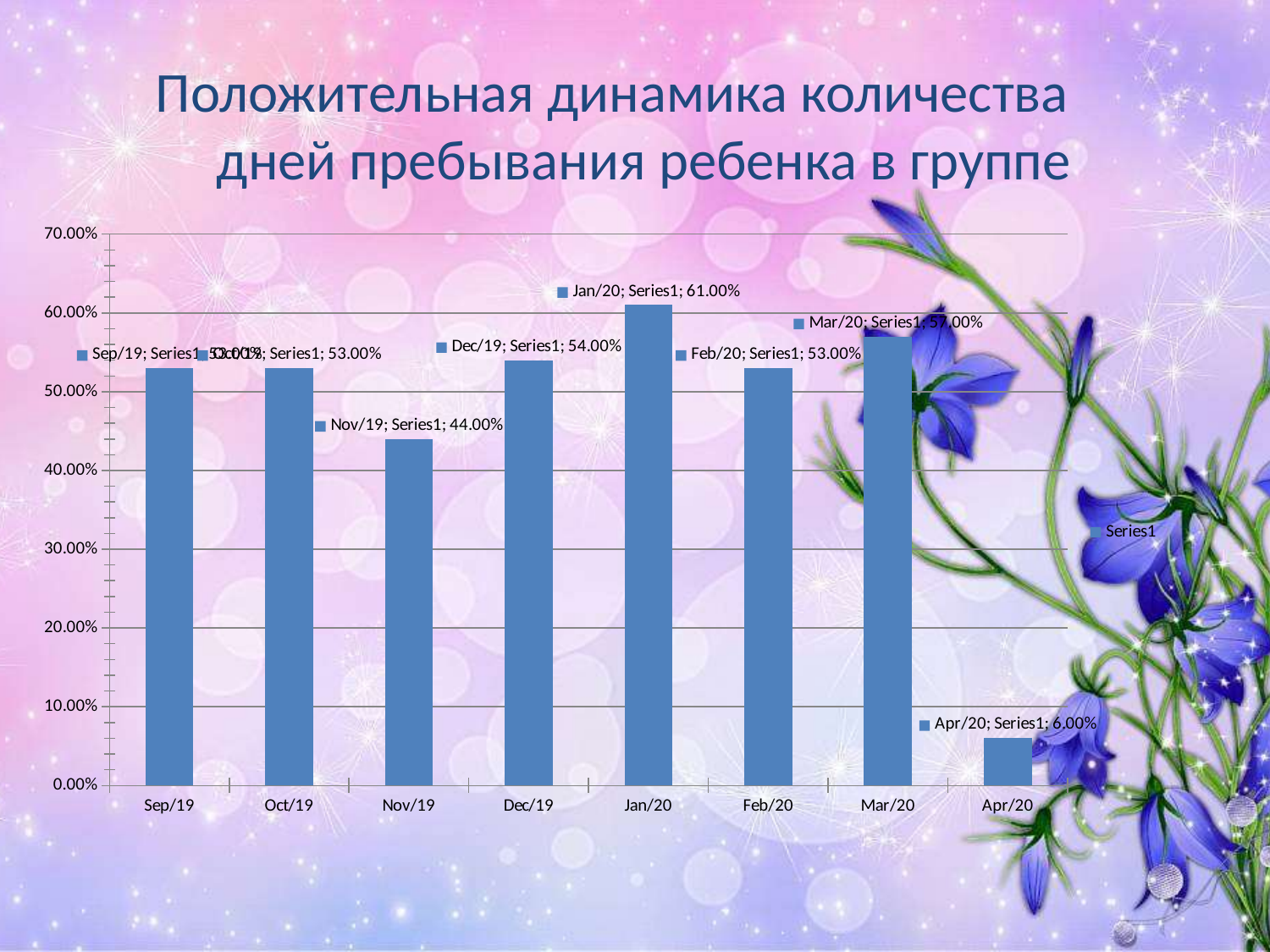
What is the value for Mar/20? 57.00% Which is larger, the value for Dec/19 or the value for Feb/20? Dec/19 What is the difference between the values for Jan/20 and Nov/19? 17.00% What is the value for Apr/20? 6.00% What is the value for Nov/19? 44.00% How many series does the legend list? 1 Is the value for Sep/19 greater or less than 50.00%? greater Which month has the highest value? Jan/20 Which month has the lowest value? Apr/20 What type of chart is shown on the slide? bar chart What is the value for Jan/20? 61.00% How many months are shown on the x axis? 8